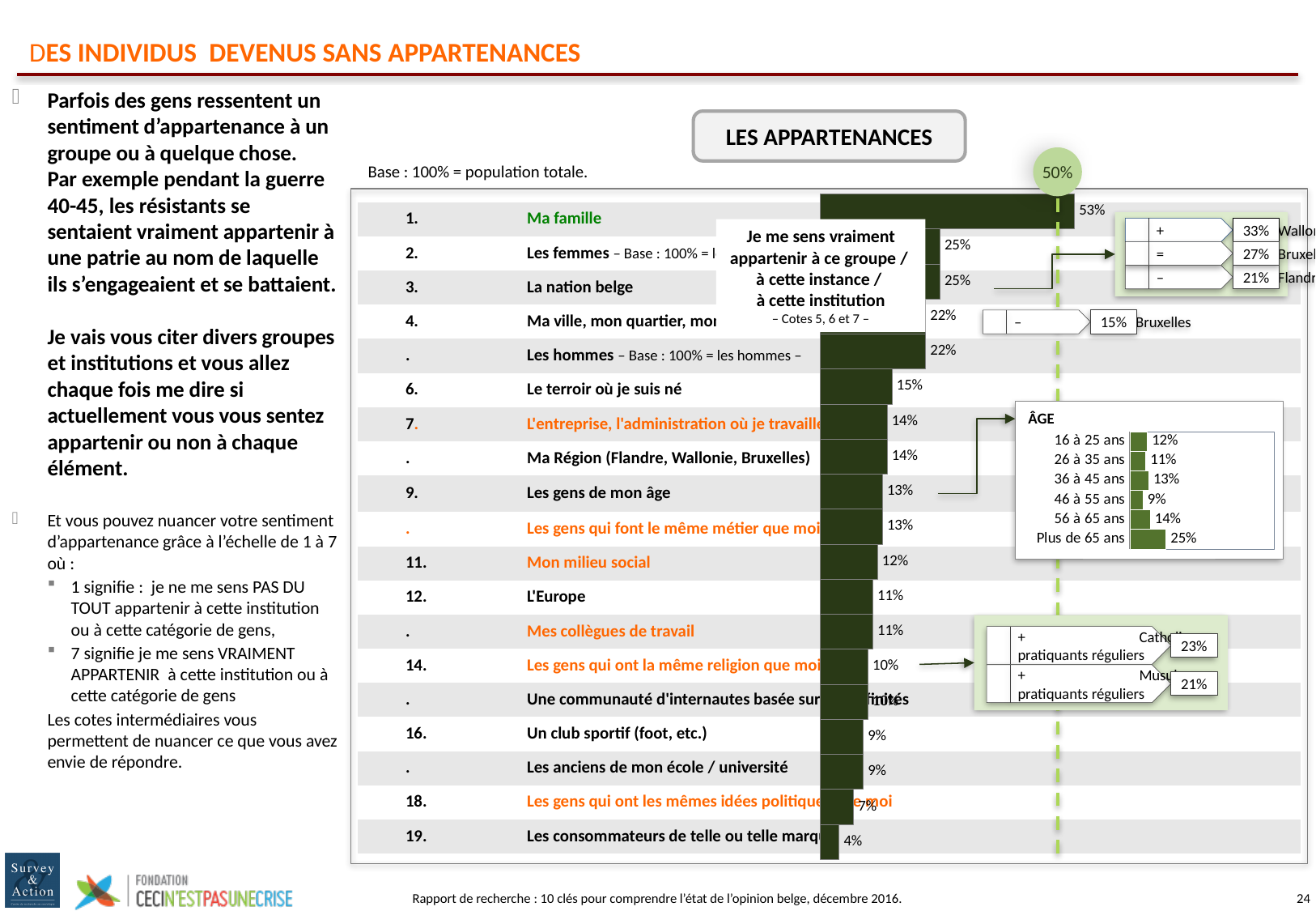
What kind of chart is the 'LES APPARTENANCES' chart? bar chart In the 'LES APPARTENANCES' chart, which is larger: 'Le terroir où je suis né' or 'L'Europe'? Le terroir où je suis né In the 'ÂGE' inset chart, what is the value for 'Plus de 65 ans'? 25% In the 'LES APPARTENANCES' chart, what is the value for 'Ma famille'? 53% In the 'ÂGE' inset chart, which age group has the lowest value? 46 à 55 ans How many age groups are shown in the 'ÂGE' inset chart? 6 In the 'LES APPARTENANCES' chart, which category has the lowest value? Les consommateurs de telle ou telle marque In the 'LES APPARTENANCES' chart, is the value for 'Ma famille' greater or less than 50%? greater In the 'LES APPARTENANCES' chart, which category has the highest value? Ma famille How many categories are listed in the 'LES APPARTENANCES' chart? 19 In the 'LES APPARTENANCES' chart, what is the difference between 'Ma famille' and 'La nation belge'? 28 percentage points In the 'LES APPARTENANCES' chart, what is the value for 'Le terroir où je suis né'? 15%